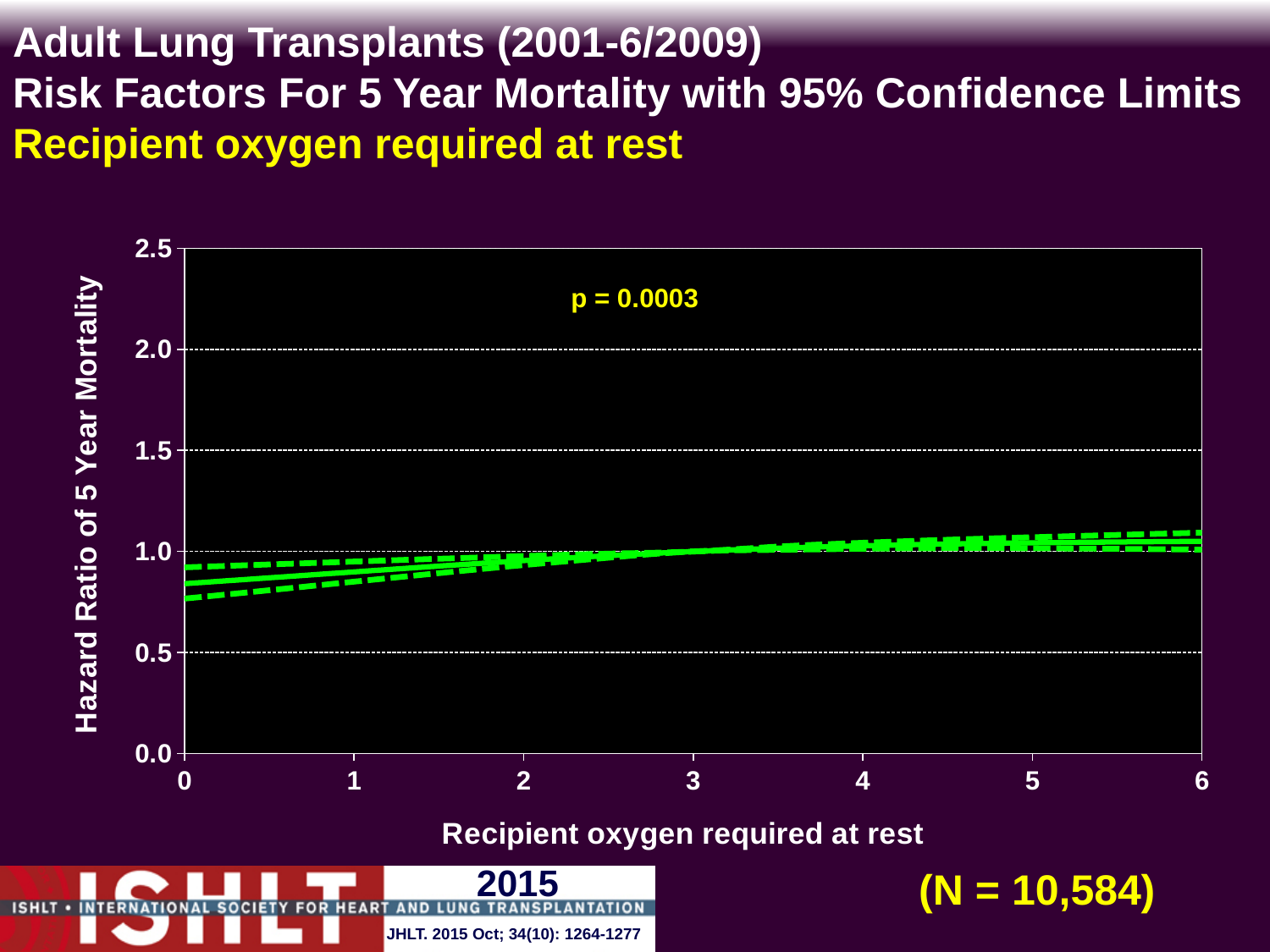
Is the hazard ratio of 5 year mortality at a recipient oxygen required at rest of 6 greater or less than 1.5? less Is the hazard ratio of 5 year mortality at a recipient oxygen required at rest of 0 greater or less than 0.5? greater Is the upper 95% confidence limit at a recipient oxygen required at rest of 6 greater or less than 1.0? greater What kind of chart is shown on the slide? line chart What p-value is shown on the chart? p = 0.0003 How many lines are plotted on the chart (the estimate plus its confidence limits)? 3 Does the hazard ratio of 5 year mortality rise or fall as recipient oxygen required at rest increases from 0 to 6? rise Is the hazard ratio of 5 year mortality higher at a recipient oxygen required at rest of 6 or at 0? 6 What is the sample size (N) shown on the slide? N = 10,584